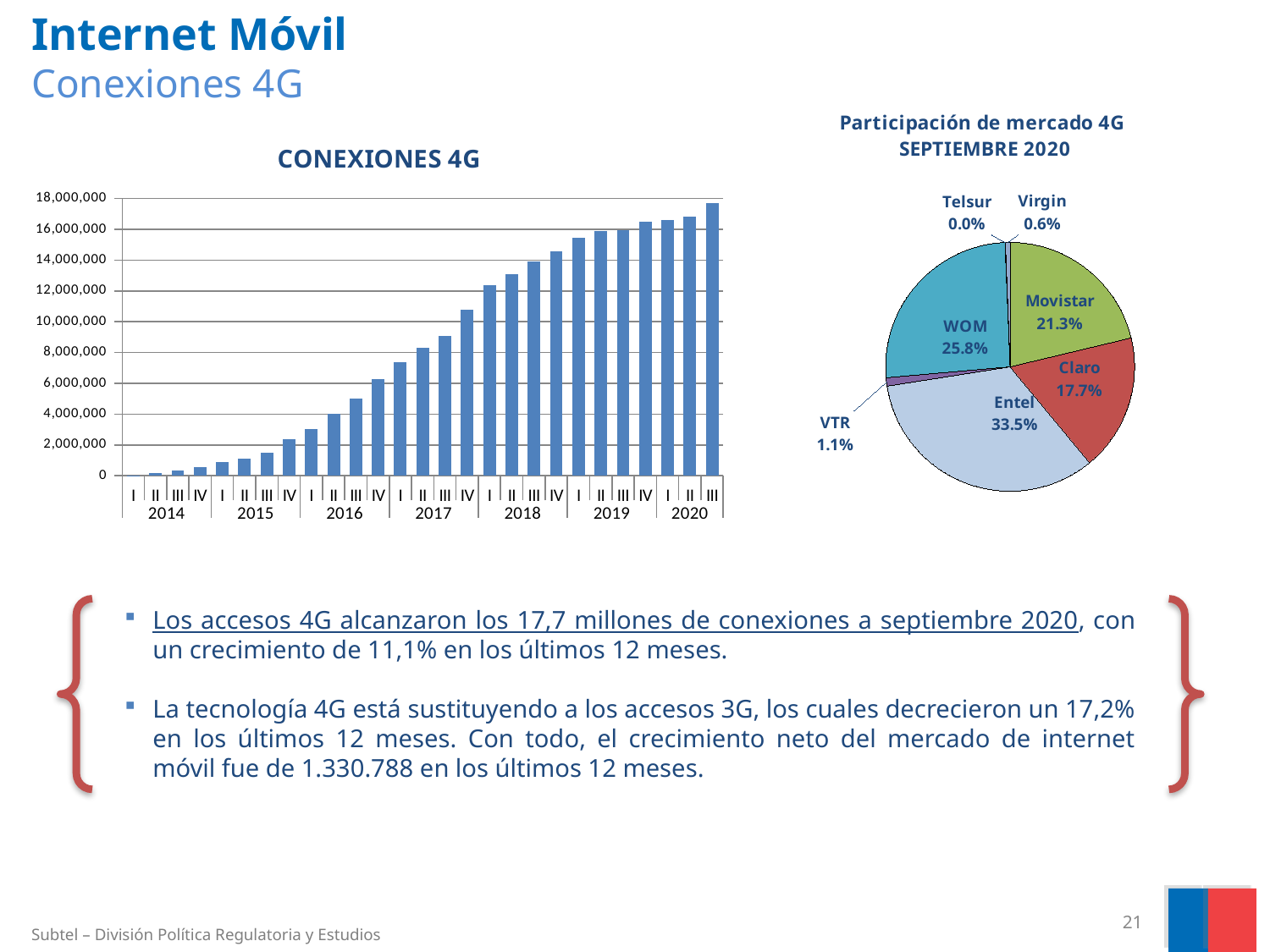
In the bar chart 'CONEXIONES 4G', do the values generally rise or fall from 2014 to 2020? Rise In the bar chart 'CONEXIONES 4G', is the value for quarter IV of 2016 greater or less than 8,000,000? less In the pie chart 'Participación de mercado 4G SEPTIEMBRE 2020', what is the difference in percentage points between Entel's and WOM's shares? 7.7 In the pie chart 'Participación de mercado 4G SEPTIEMBRE 2020', which operator has the largest market share? Entel In the pie chart 'Participación de mercado 4G SEPTIEMBRE 2020', what is the market share of Entel? 33.5% In the bar chart 'CONEXIONES 4G', is the value for quarter III of 2020 greater or less than 16,000,000? greater What kind of chart is 'CONEXIONES 4G'? Bar chart In the pie chart 'Participación de mercado 4G SEPTIEMBRE 2020', what is the market share of WOM? 25.8% In the pie chart 'Participación de mercado 4G SEPTIEMBRE 2020', which operator has the smallest market share? Telsur In the pie chart 'Participación de mercado 4G SEPTIEMBRE 2020', which has a larger share, Movistar or Claro? Movistar In the pie chart 'Participación de mercado 4G SEPTIEMBRE 2020', how many operators are labelled? 7 In the bar chart 'CONEXIONES 4G', how many quarterly bars are plotted? 27